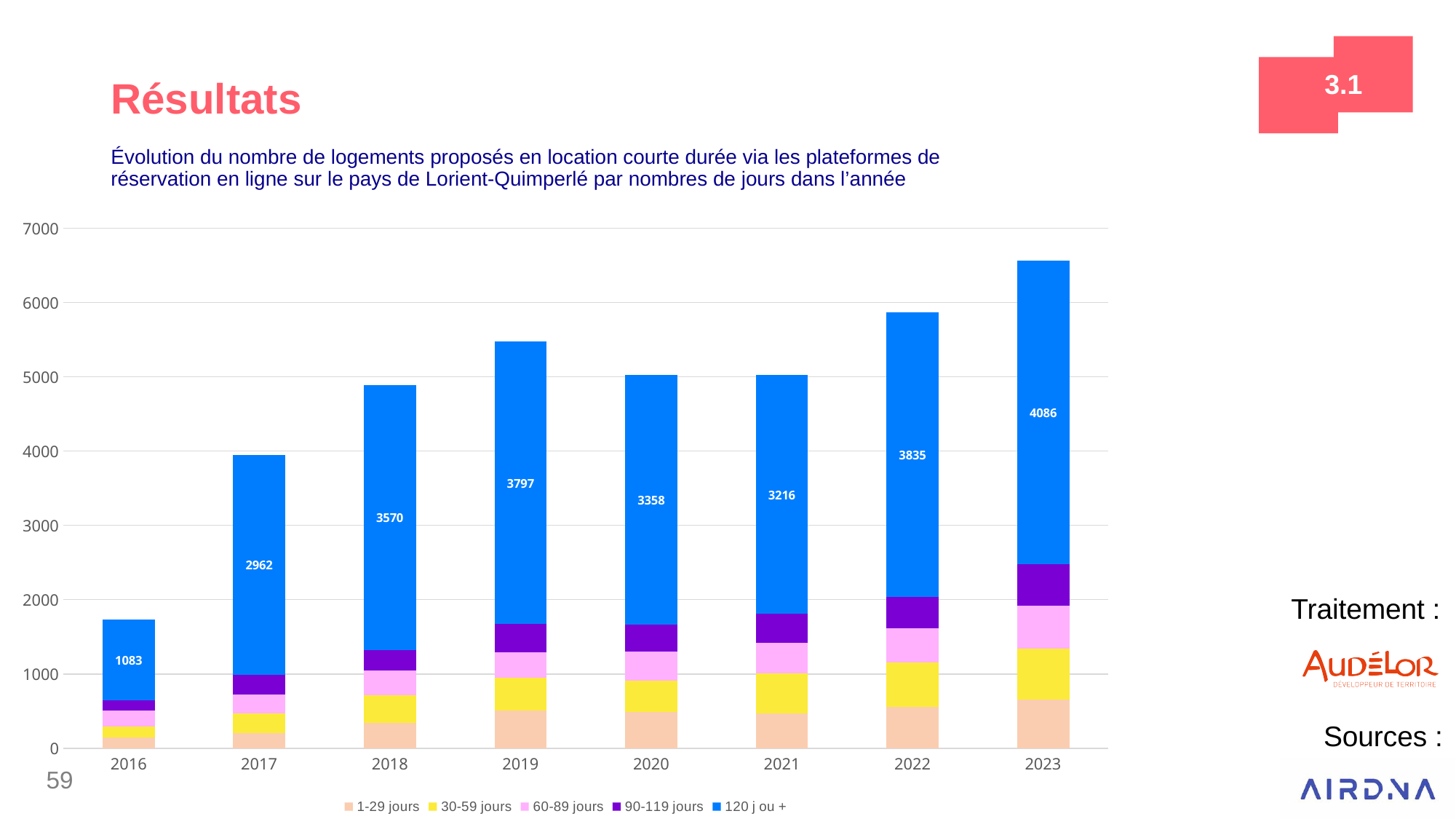
How many series does the legend list? 5 Is the total height of the 2016 bar greater or less than 2000? less What is the difference between the "120 j ou +" values for 2023 and 2022? 251 Which year has the lowest value for the "120 j ou +" series? 2016 Which year has the highest value for the "120 j ou +" series? 2023 Is the total height of the 2023 bar greater or less than 6000? greater Which year has the larger "120 j ou +" value, 2019 or 2020? 2019 How many years are shown on the x axis? 8 What is the value of the "120 j ou +" segment for 2019? 3797 What is the value of the "120 j ou +" segment for 2016? 1083 What kind of chart is shown on the slide? Stacked bar chart What is the value of the "120 j ou +" segment for 2023? 4086